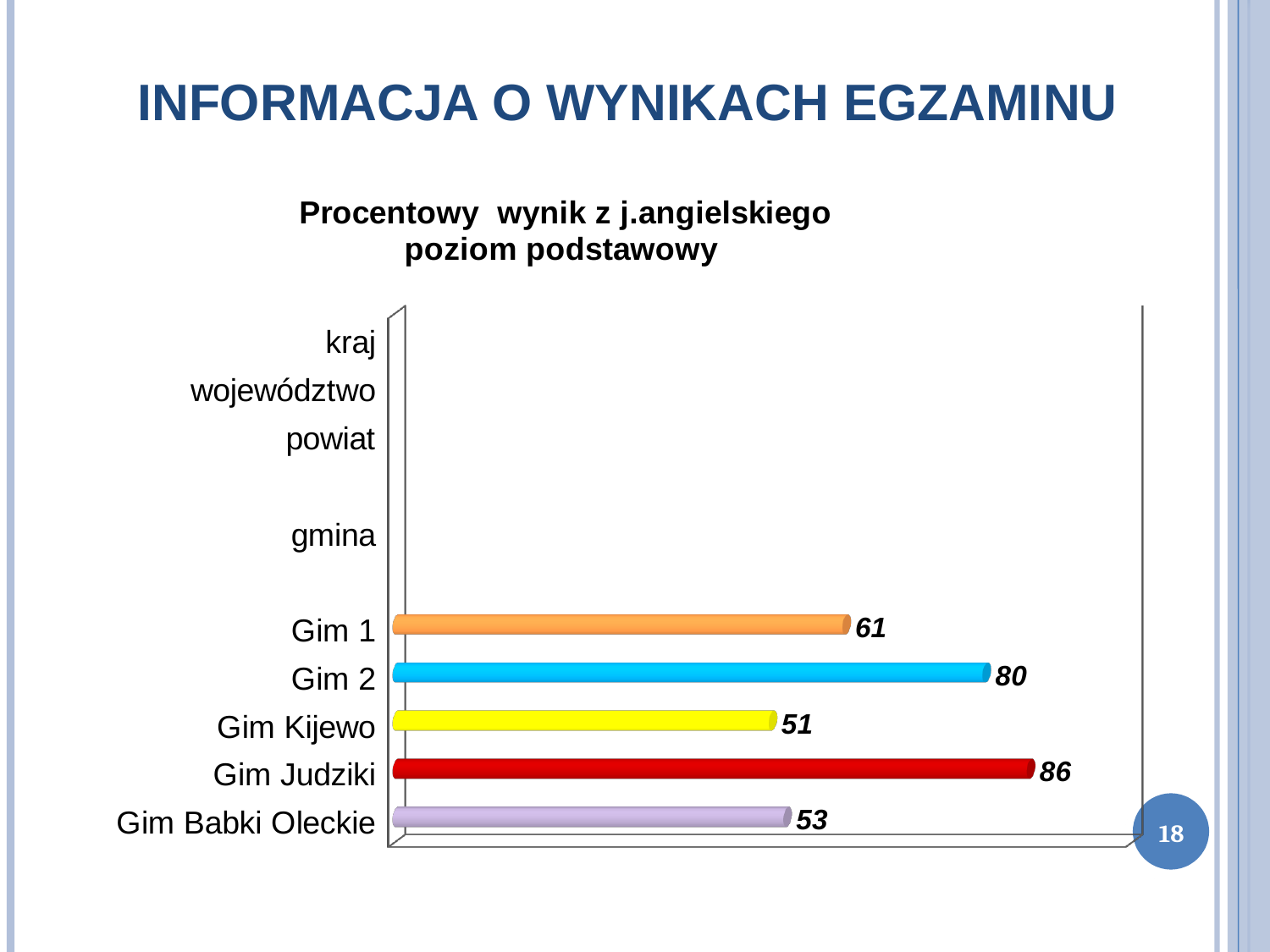
What is the value for Gim Babki Oleckie? 53 What is the value for Gim Kijewo? 51 What is the title of the chart? Procentowy wynik z j.angielskiego poziom podstawowy Which is larger, the value for Gim 2 or the value for Gim 1? Gim 2 Which category has the highest value? Gim Judziki What is the value for Gim Judziki? 86 What is the difference between the values for Gim Judziki and Gim Kijewo? 35 What kind of chart is shown? bar chart What is the value for Gim 2? 80 What is the value for Gim 1? 61 How many bars are plotted on the chart? 5 Which category has the lowest plotted value? Gim Kijewo